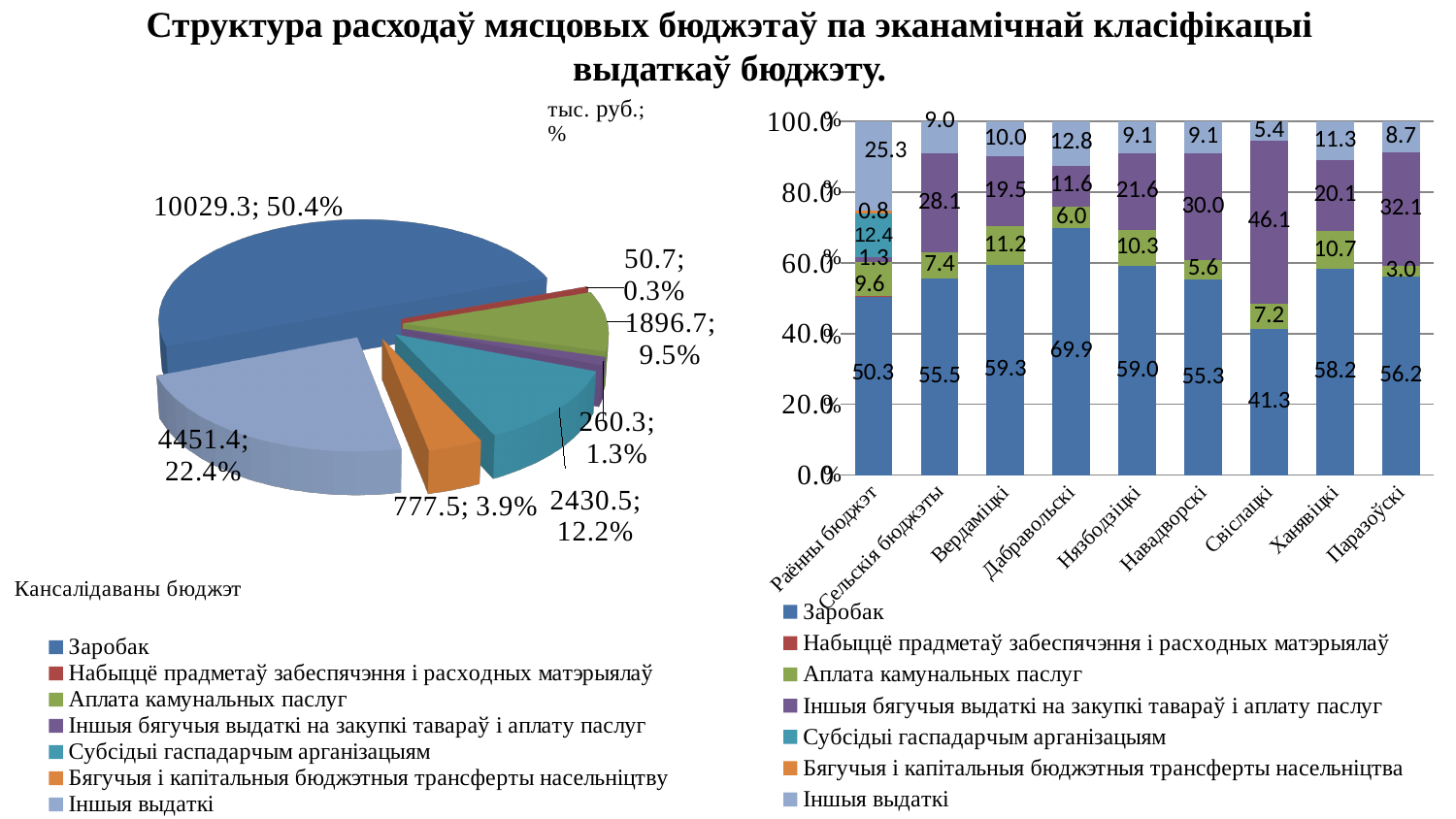
On the pie chart, how many slices are there? 7 On the pie chart, which category has the smallest slice? Набыццё прадметаў забеспячэння і расходных матэрыялаў On the pie chart, what value is shown for Субсідыі гаспадарчым арганізацыям? 2430.5 On the stacked bar chart, what is the Заробак value for Дабравольскі? 69.9 On the stacked bar chart, which category has the highest Заробак value? Дабравольскі On the stacked bar chart, what is the difference between the Заробак values for Дабравольскі and Свіслацкі? 28.6 On the stacked bar chart, which category has the lowest Заробак value? Свіслацкі On the stacked bar chart, what is the Заробак value for Свіслацкі? 41.3 On the stacked bar chart, how many categories are shown on the x axis? 9 What type of chart is the chart on the right side of the slide? Stacked bar chart On the pie chart (Кансалідаваны бюджэт), what value and share are shown for Заробак? 10029.3; 50.4% On the pie chart, what share does Іншыя выдаткі have? 22.4%